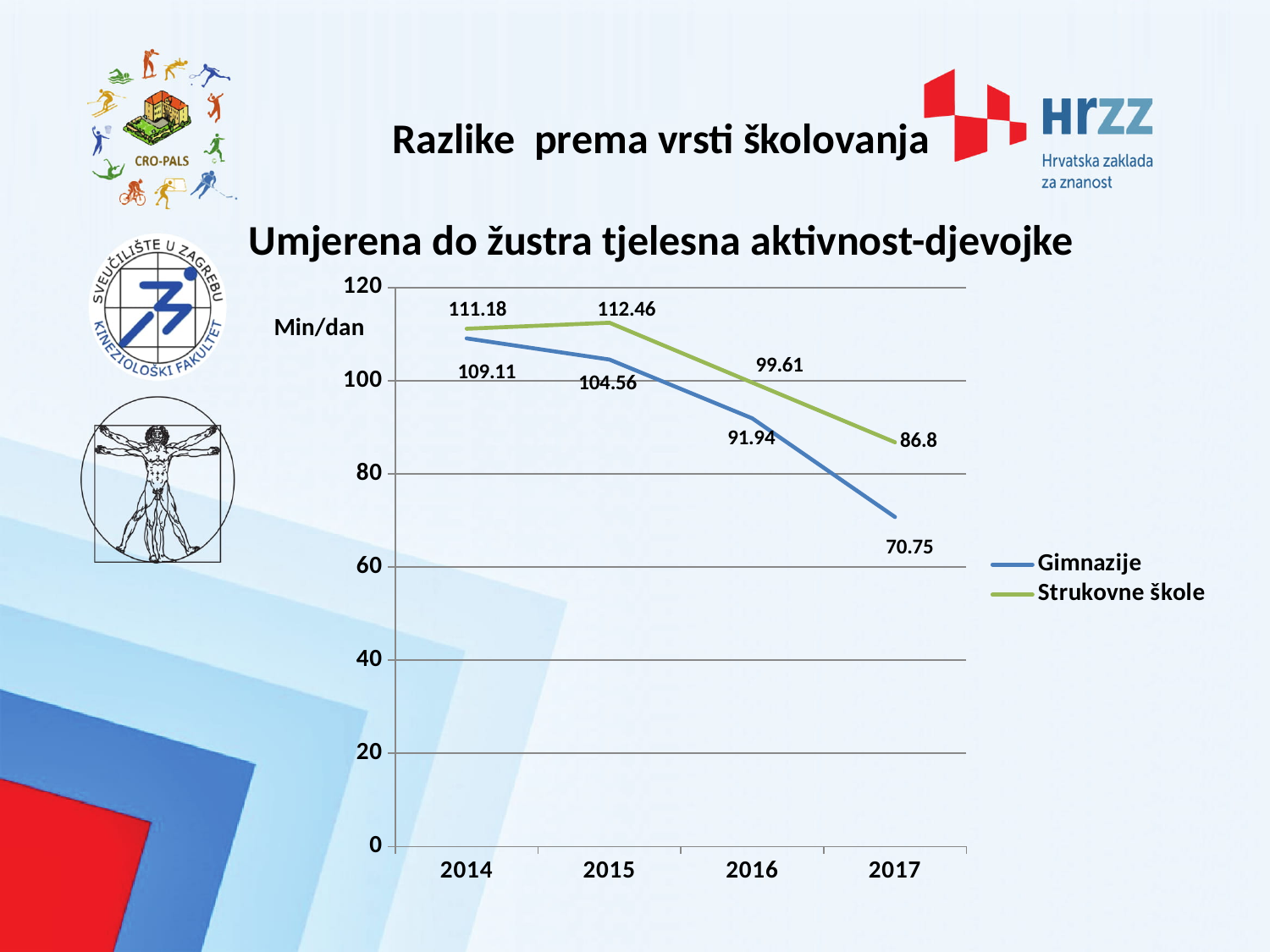
What is the value for Strukovne škole in 2017? 86.8 How many series does the legend list? 2 What kind of chart is shown? line chart In which year is the Strukovne škole value highest? 2015 In which year is the Gimnazije value lowest? 2017 What is the difference between Strukovne škole and Gimnazije in 2017? 16.05 Does the Gimnazije series rise or fall from 2014 to 2017? fall What is the value for Strukovne škole in 2015? 112.46 What is the value for Gimnazije in 2014? 109.11 Which series has the larger value in 2016, Gimnazije or Strukovne škole? Strukovne škole How many years are shown on the x axis? 4 What is the value for Gimnazije in 2016? 91.94